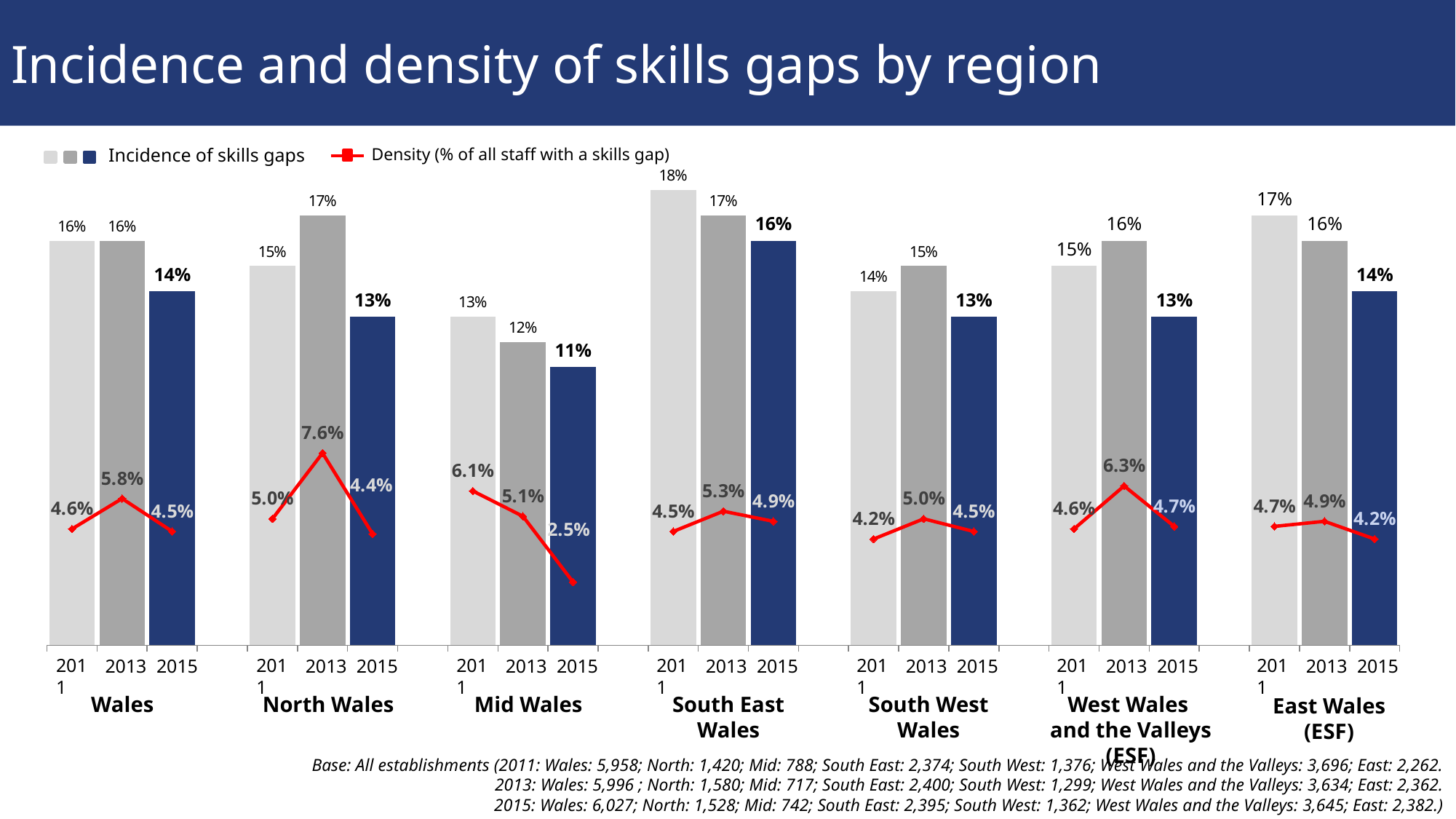
What does the red line on the chart represent? Density (% of all staff with a skills gap) Which was higher in 2013: the density of skills gaps in West Wales and the Valleys (ESF) or in East Wales (ESF)? West Wales and the Valleys (ESF) What was the density of skills gaps in North Wales in 2013? 7.6% What is the difference between the 2013 and 2015 incidence of skills gaps in North Wales? 4 percentage points How many regions are shown on the chart? 7 What was the density of skills gaps in Wales (all) in 2011? 4.6% How did the incidence of skills gaps in Mid Wales change from 2011 to 2015? It fell What was the incidence of skills gaps in Mid Wales in 2015? 11% Which region had the highest incidence of skills gaps in 2015? South East Wales Which region had the lowest density of skills gaps in 2015? Mid Wales What type of chart is used to show the incidence of skills gaps? Bar chart What was the incidence of skills gaps in South East Wales in 2011? 18%